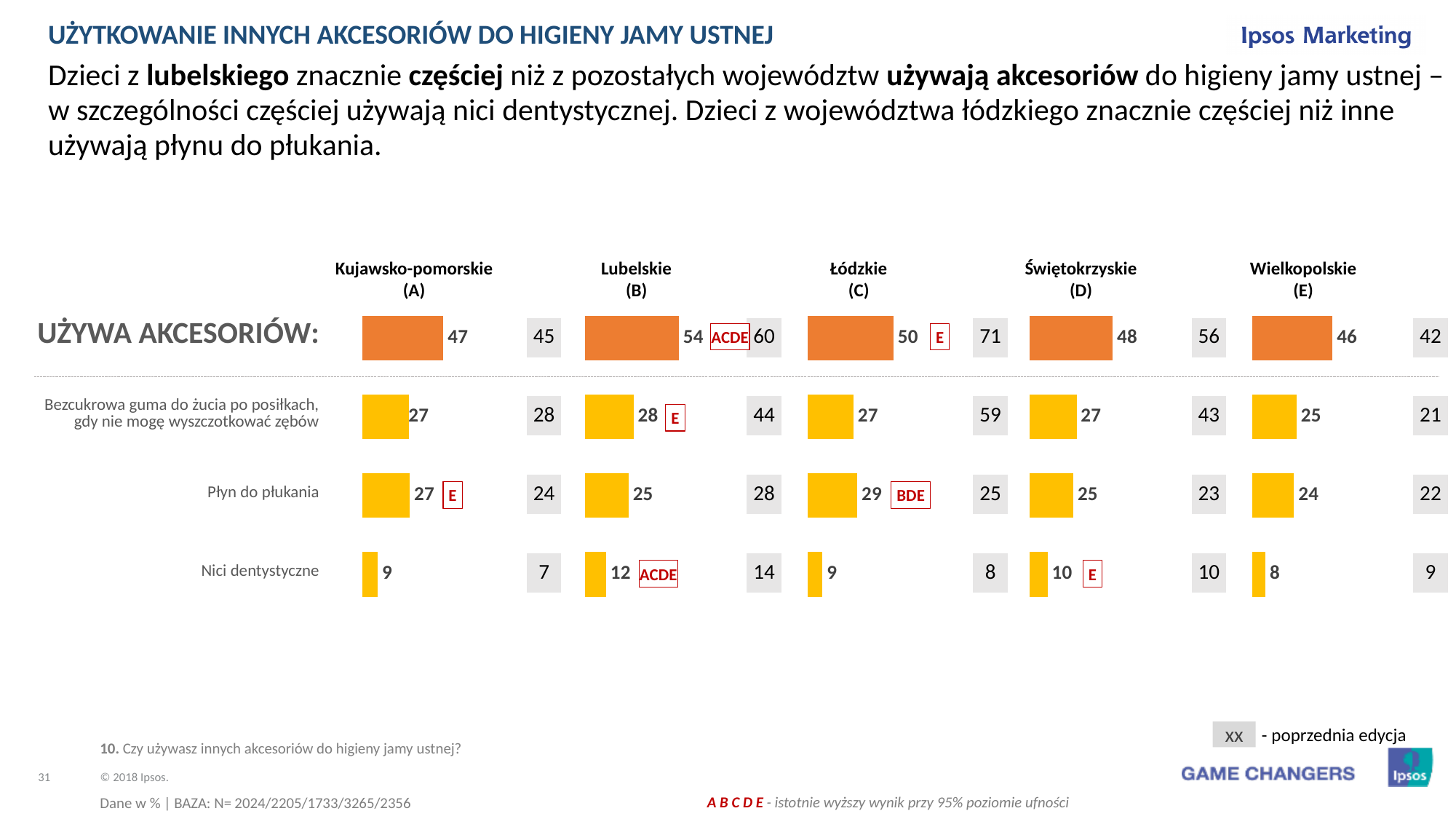
What is the difference between the 'Używa akcesoriów' values for Lubelskie (B) and Wielkopolskie (E)? 8 What was the previous edition value (grey box) for 'Używa akcesoriów' in Łódzkie (C)? 71 Which is larger: the 'Nici dentystyczne' value for Lubelskie (B) or for Wielkopolskie (E)? Lubelskie (B) Which voivodeship has the lowest value for 'Używa akcesoriów'? Wielkopolskie (E) What is the value for 'Bezcukrowa guma do żucia po posiłkach, gdy nie mogę wyszczotkować zębów' in Wielkopolskie (E)? 25 Which voivodeship has the highest value for 'Używa akcesoriów'? Lubelskie (B) How many voivodeships are shown in the chart? 5 What is the value for 'Płyn do płukania' in Łódzkie (C)? 29 What is the value for 'Używa akcesoriów' in Lubelskie (B)? 54 What kind of chart is used to show the values on this slide? Bar chart What does the grey box marked 'xx' in the legend represent? poprzednia edycja What is the value for 'Nici dentystyczne' in Lubelskie (B)? 12